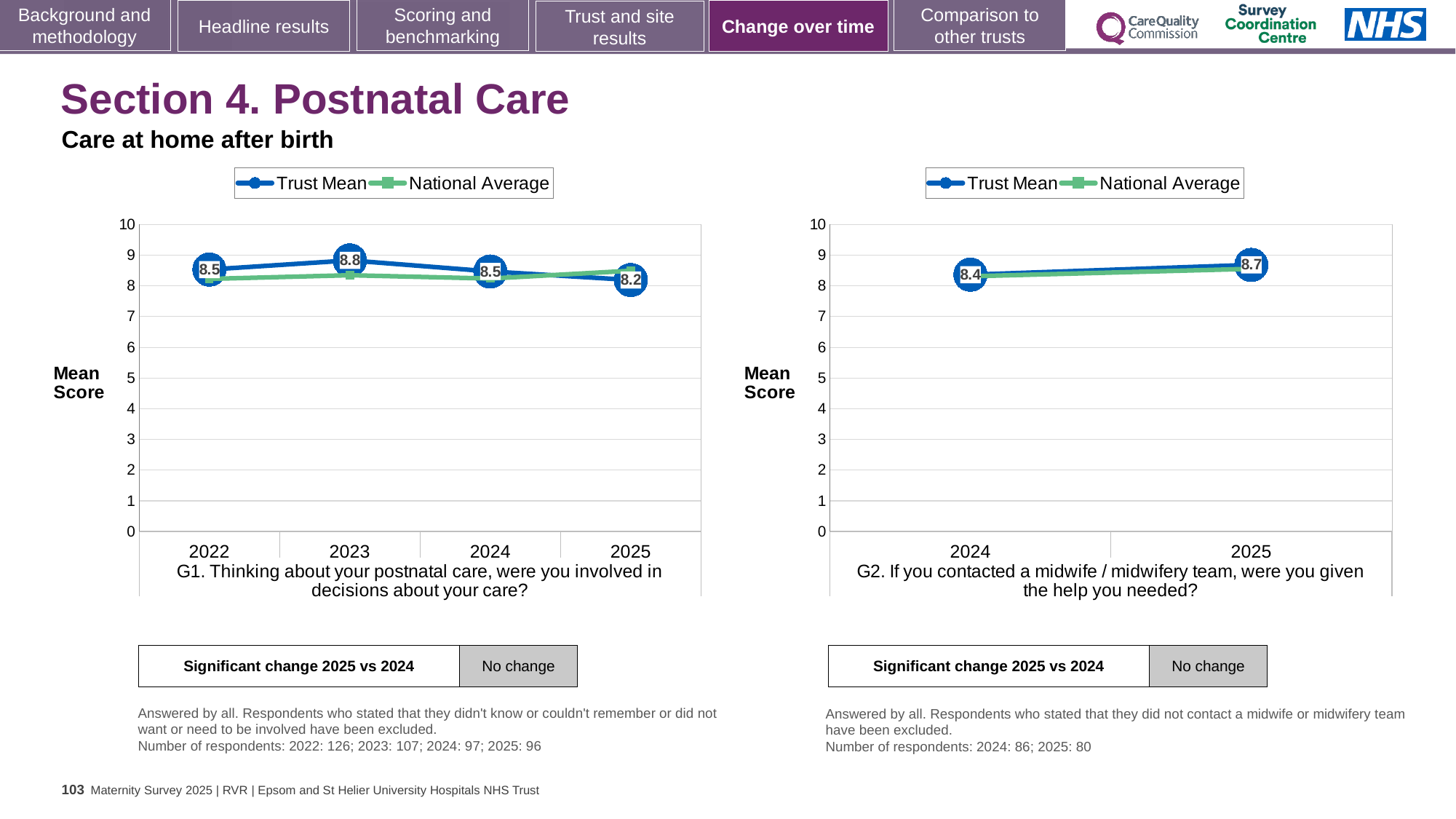
In the G2 chart (right), what is the Trust Mean for 2024? 8.4 In the G1 chart (left), what is the Trust Mean for 2025? 8.2 In the G1 chart (left), which year has the lowest Trust Mean? 2025 In the G1 chart (left), how many years are shown on the x axis? 4 What kind of chart is the G1 chart (left)? line chart In the G1 chart (left), is the National Average for 2022 greater or less than 9? less In the G1 chart (left), what is the difference between the Trust Mean in 2023 and in 2025? 0.6 In the G1 chart (left), what is the Trust Mean for 2023? 8.8 In the G1 chart (left), which year has the highest Trust Mean? 2023 In the G2 chart (right), what is the Trust Mean for 2025? 8.7 How many series does the legend of the G2 chart (right) list? 2 In the G2 chart (right), does the Trust Mean rise or fall from 2024 to 2025? rise